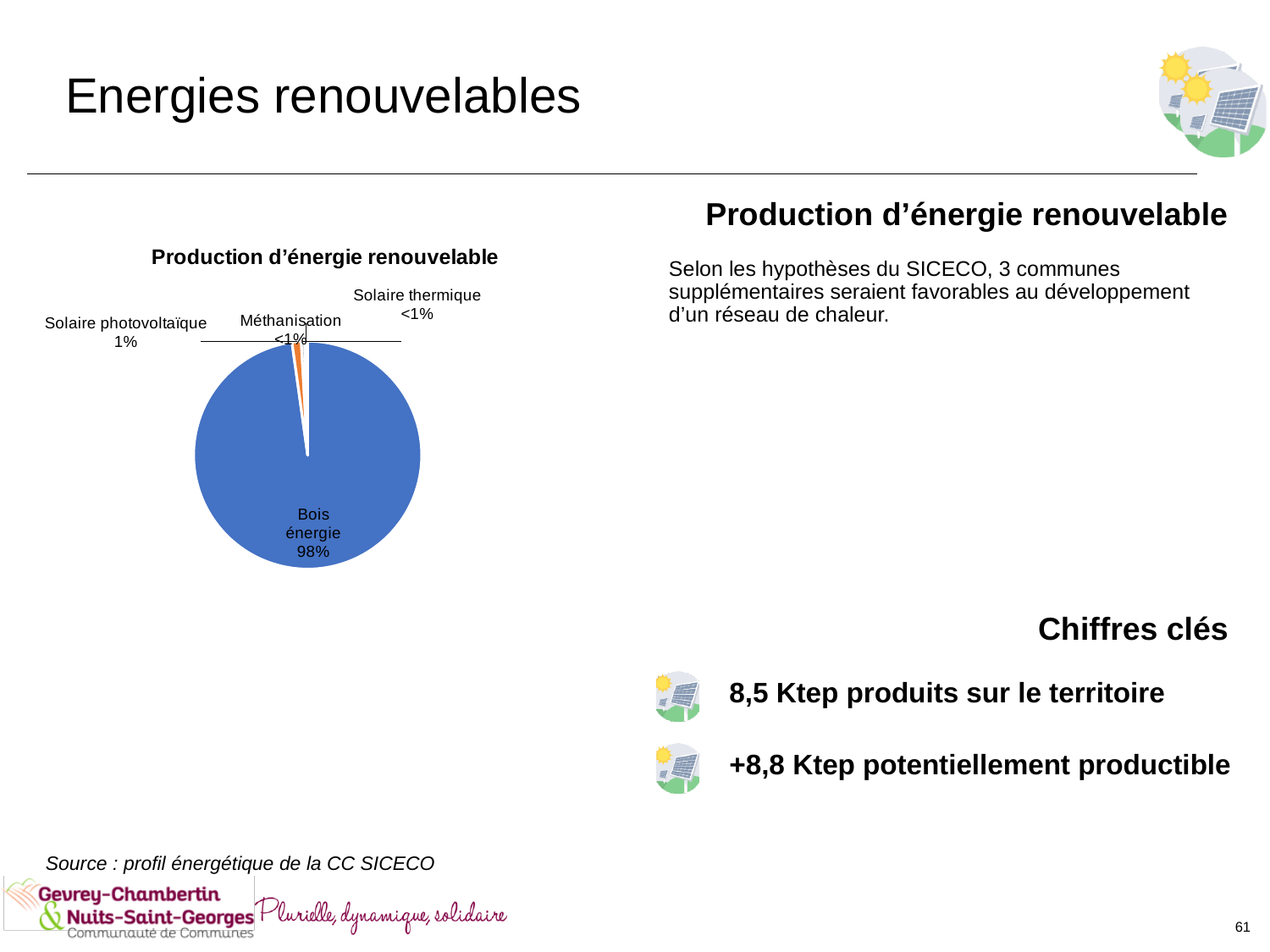
What share is shown for Solaire thermique? <1% How many categories are shown in the pie chart? 4 What share of the pie does Solaire photovoltaïque represent? 1% What is the title of the chart? Production d’énergie renouvelable Which category has the largest slice of the pie? Bois énergie Is the share for Bois énergie greater or less than 50%? greater What colour is the Bois énergie slice? blue Which is larger, the slice for Bois énergie or the slice for Solaire photovoltaïque? Bois énergie What share of the pie does Bois énergie represent? 98% What kind of chart is shown on the slide? pie chart What share is shown for Méthanisation? <1%